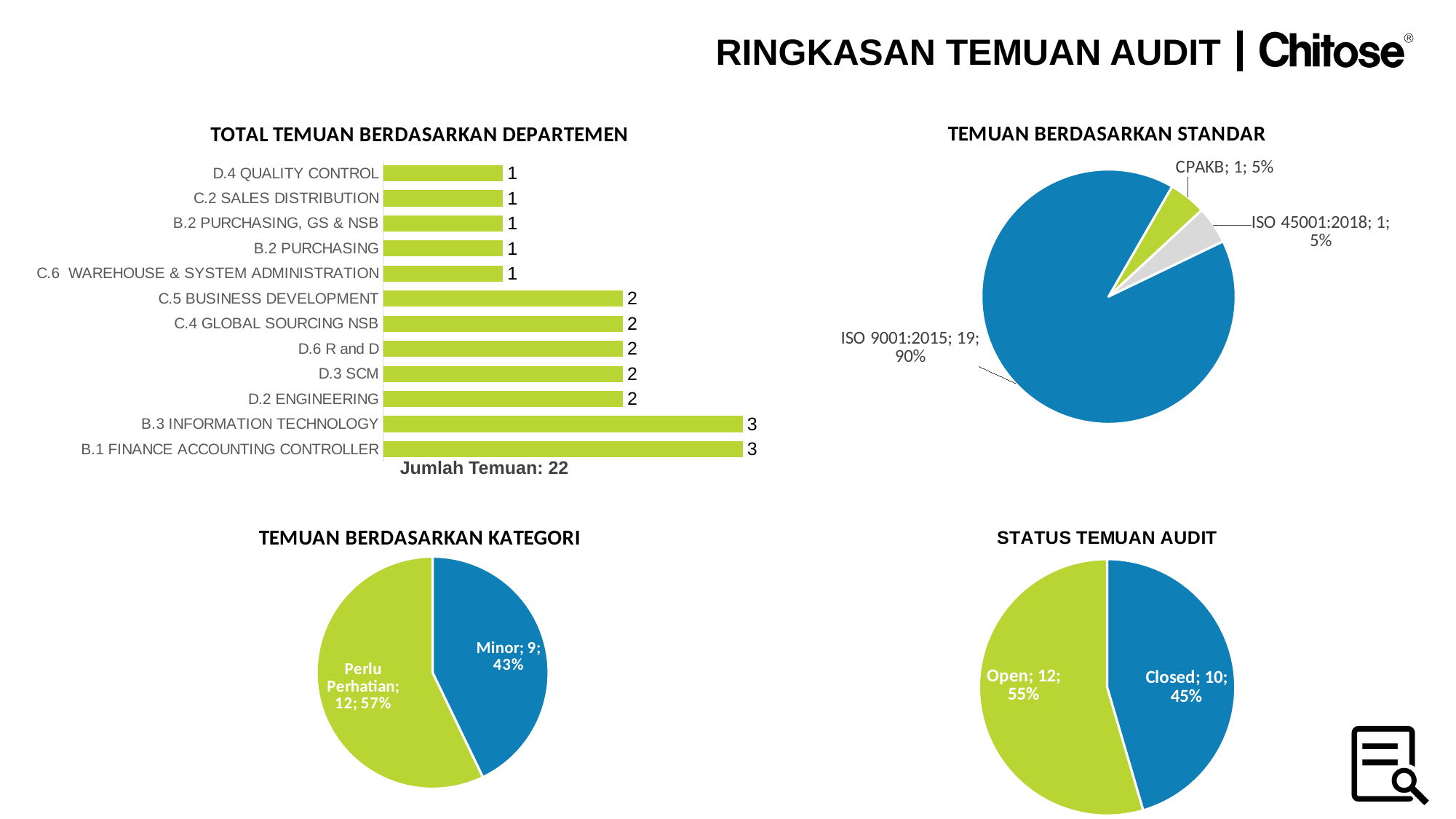
In the 'STATUS TEMUAN AUDIT' pie chart, what is the difference between Open and Closed? 2 In the 'TEMUAN BERDASARKAN STANDAR' pie chart, which standard has the largest slice? ISO 9001:2015 What kind of chart is 'TOTAL TEMUAN BERDASARKAN DEPARTEMEN'? bar chart In the 'TOTAL TEMUAN BERDASARKAN DEPARTEMEN' chart, what is the value for D.6 R and D? 2 In the 'TOTAL TEMUAN BERDASARKAN DEPARTEMEN' chart, what is the difference between B.1 FINANCE ACCOUNTING CONTROLLER and D.4 QUALITY CONTROL? 2 In the 'TOTAL TEMUAN BERDASARKAN DEPARTEMEN' chart, what is the value for B.3 INFORMATION TECHNOLOGY? 3 In the 'TEMUAN BERDASARKAN STANDAR' pie chart, what is the value for ISO 9001:2015? 19 In the 'STATUS TEMUAN AUDIT' pie chart, what share is Open? 55% In the 'TOTAL TEMUAN BERDASARKAN DEPARTEMEN' chart, which is larger, C.5 BUSINESS DEVELOPMENT or B.2 PURCHASING? C.5 BUSINESS DEVELOPMENT In the 'TOTAL TEMUAN BERDASARKAN DEPARTEMEN' chart, how many departments are listed? 12 In the 'TEMUAN BERDASARKAN STANDAR' pie chart, what share does CPAKB have? 5% In the 'TEMUAN BERDASARKAN KATEGORI' pie chart, what is the value for Minor? 9